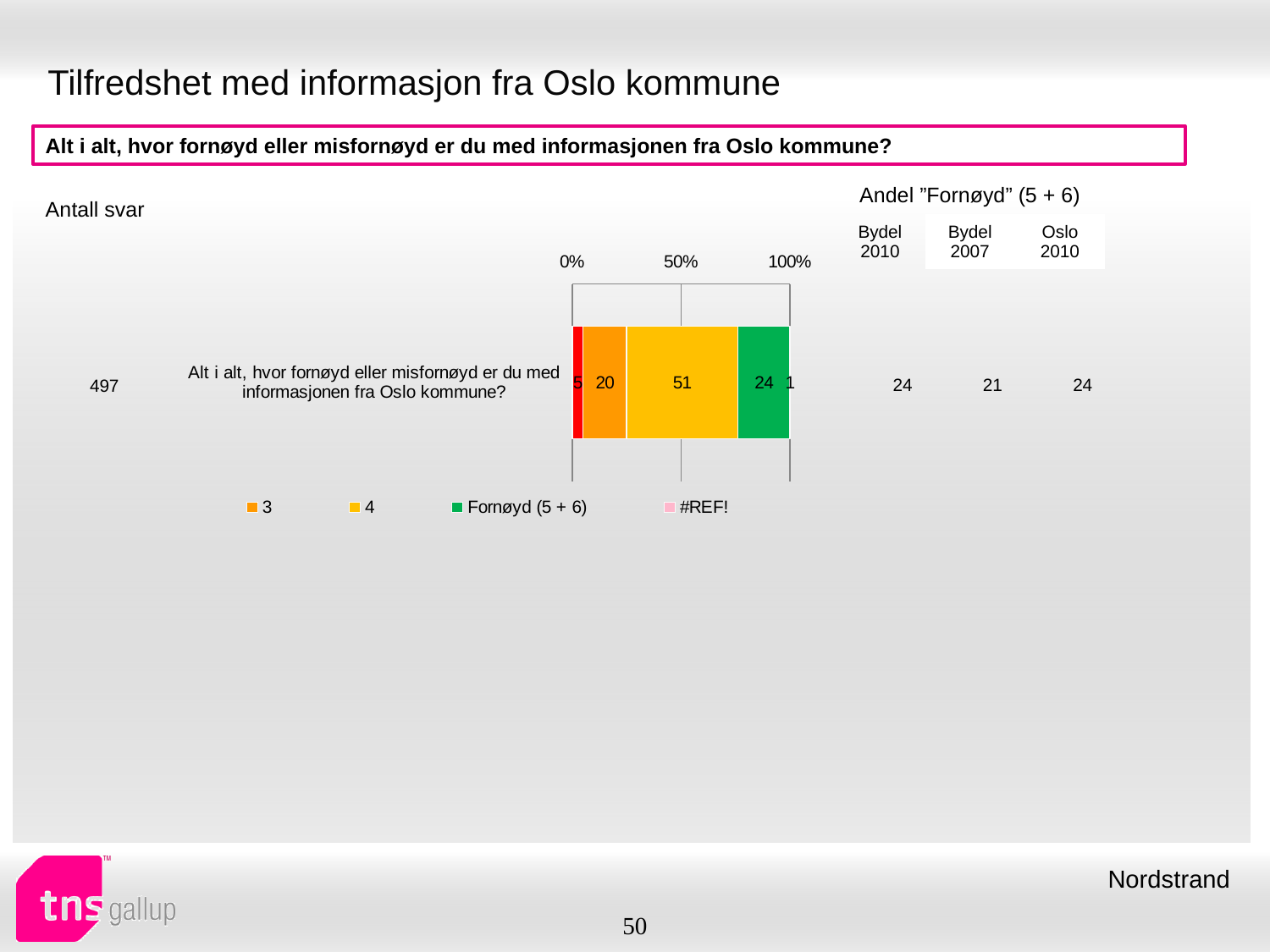
What is the value of the '#REF!' segment in the stacked bar? 1 What is the value of the '3' segment in the stacked bar? 20 What is the value of the '4' segment in the stacked bar? 51 What is the 'Antall svar' (number of responses) shown next to the chart? 497 How many bars (categories) are plotted in the chart? 1 What is the value of the 'Fornøyd (5 + 6)' segment in the stacked bar? 24 What is the difference between the '4' segment and the '3' segment? 31 In the 'Andel Fornøyd (5 + 6)' table, what is the value for Bydel 2007? 21 Which legend series has the largest segment in the stacked bar? 4 Which is larger, the '3' segment or the 'Fornøyd (5 + 6)' segment? Fornøyd (5 + 6) What kind of chart is shown on the slide? bar chart How many series does the legend list? 4